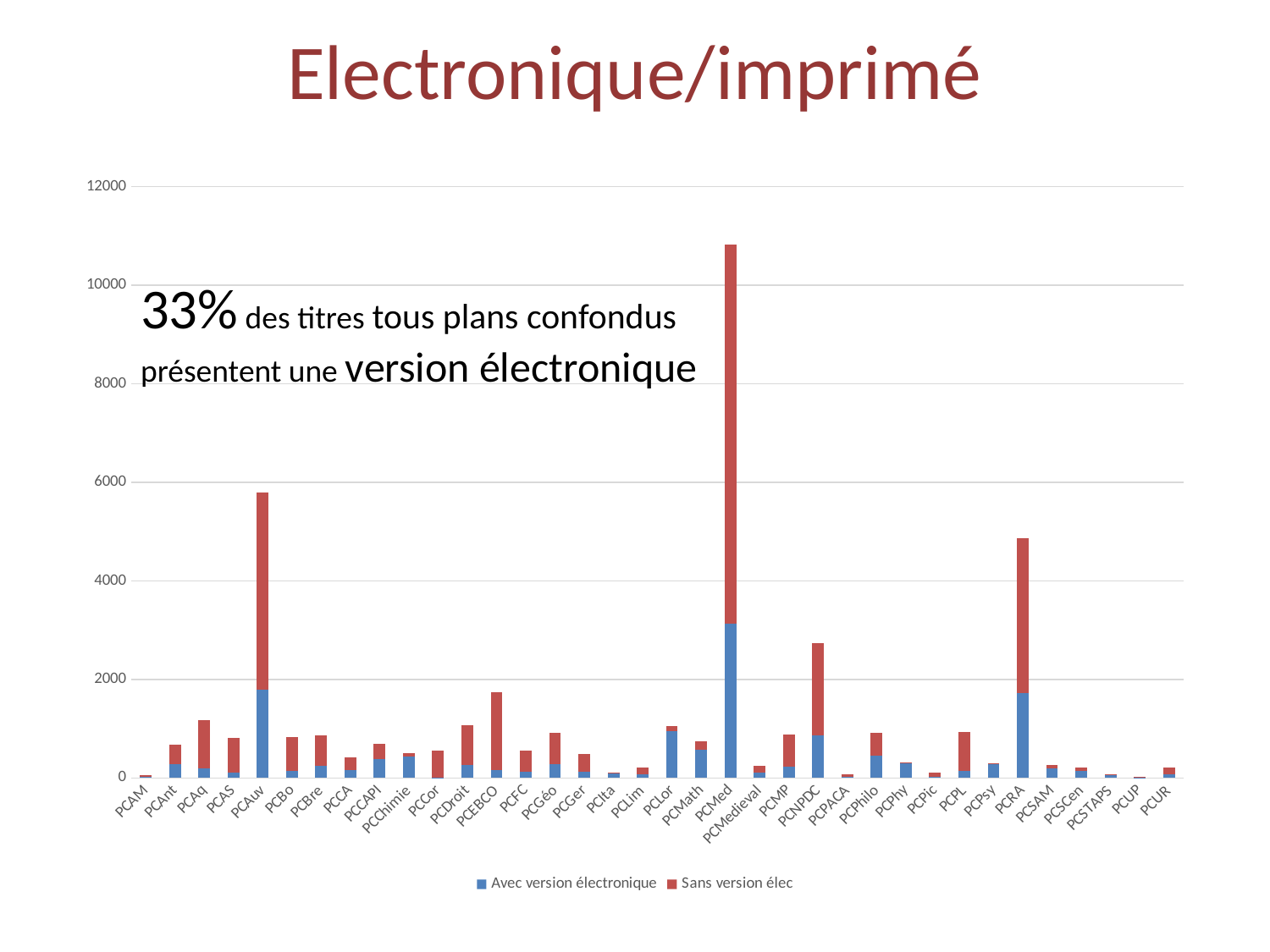
What is the title of the slide containing the chart? Electronique/imprimé Is the total stacked value for PCNPDC greater or less than 2000? greater Is the total stacked value for PCAnt greater or less than 2000? less What kind of chart is shown on the slide? bar chart Which category has the tallest stacked bar? PCMed Which has the taller stacked bar, PCEBCO or PCDroit? PCEBCO How many series does the legend list? 2 Is the total stacked value for PCRA greater or less than 6000? less What are the two series named in the legend? Avec version électronique; Sans version élec Which has the taller stacked bar, PCAuv or PCRA? PCAuv